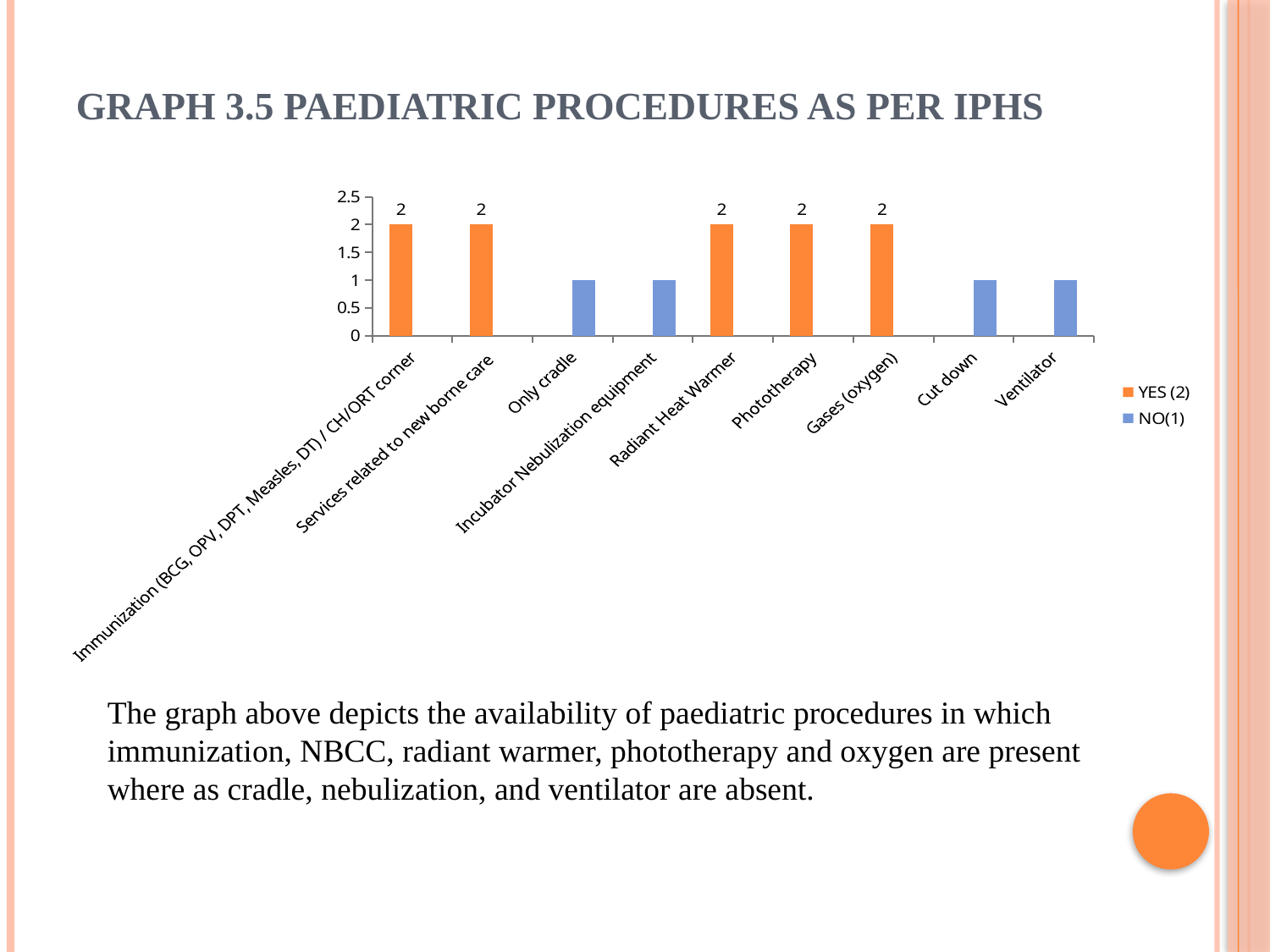
What is the difference between the value for Phototherapy and the value for Incubator Nebulization equipment? 1 What is the value for Gases (oxygen)? 2 What kind of chart is shown on the slide? bar chart Is the value for Cut down greater or less than 1.5? less What is the value for Phototherapy? 2 What is the value for Radiant Heat Warmer? 2 Which series is shown in orange according to the legend? YES (2) What is the value for Only cradle? 1 How many series does the legend list? 2 How many categories are shown on the x axis? 9 What is the value for Ventilator? 1 Which is larger, the value for Services related to new borne care or the value for Cut down? Services related to new borne care